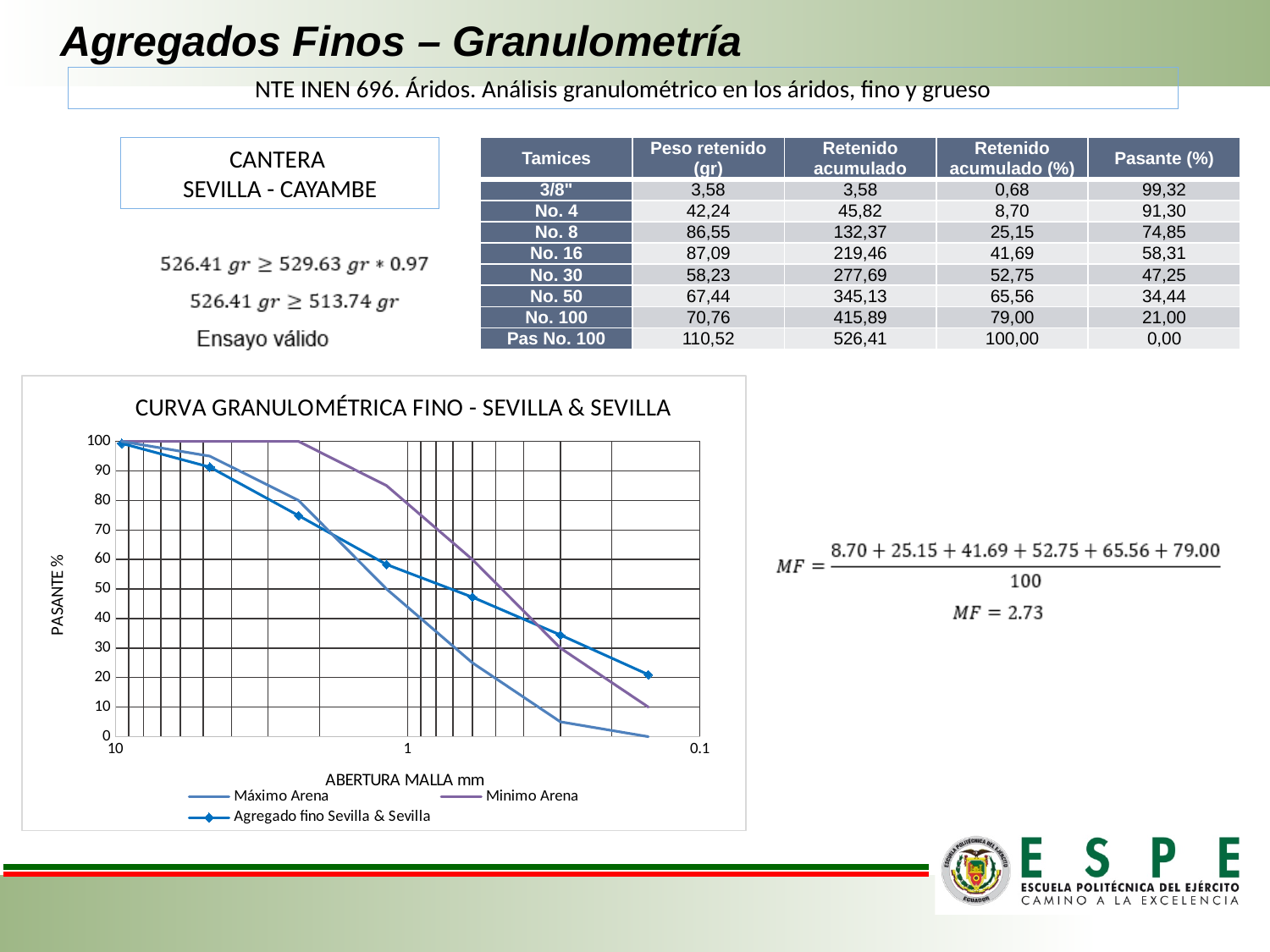
Do the values of the Agregado fino Sevilla & Sevilla series rise or fall moving from left to right along the x axis? fall At an opening of 1 mm, which series has the higher value, Máximo Arena or Minimo Arena? Minimo Arena Which series has the highest value at the right-hand end of the chart? Agregado fino Sevilla & Sevilla Is the value of the Agregado fino Sevilla & Sevilla series at an opening of 1 mm greater or less than 50? greater What kind of chart is shown on the slide? line chart Is the value of the Minimo Arena series at an opening of 1 mm greater or less than 70? greater Is the value of the Minimo Arena series at its right-hand end greater or less than 20? less What is the label of the y axis of the chart? PASANTE % What is the title of the chart? CURVA GRANULOMÉTRICA FINO - SEVILLA & SEVILLA How many marked data points does the Agregado fino Sevilla & Sevilla series have? 7 How many series does the legend of the chart list? 3